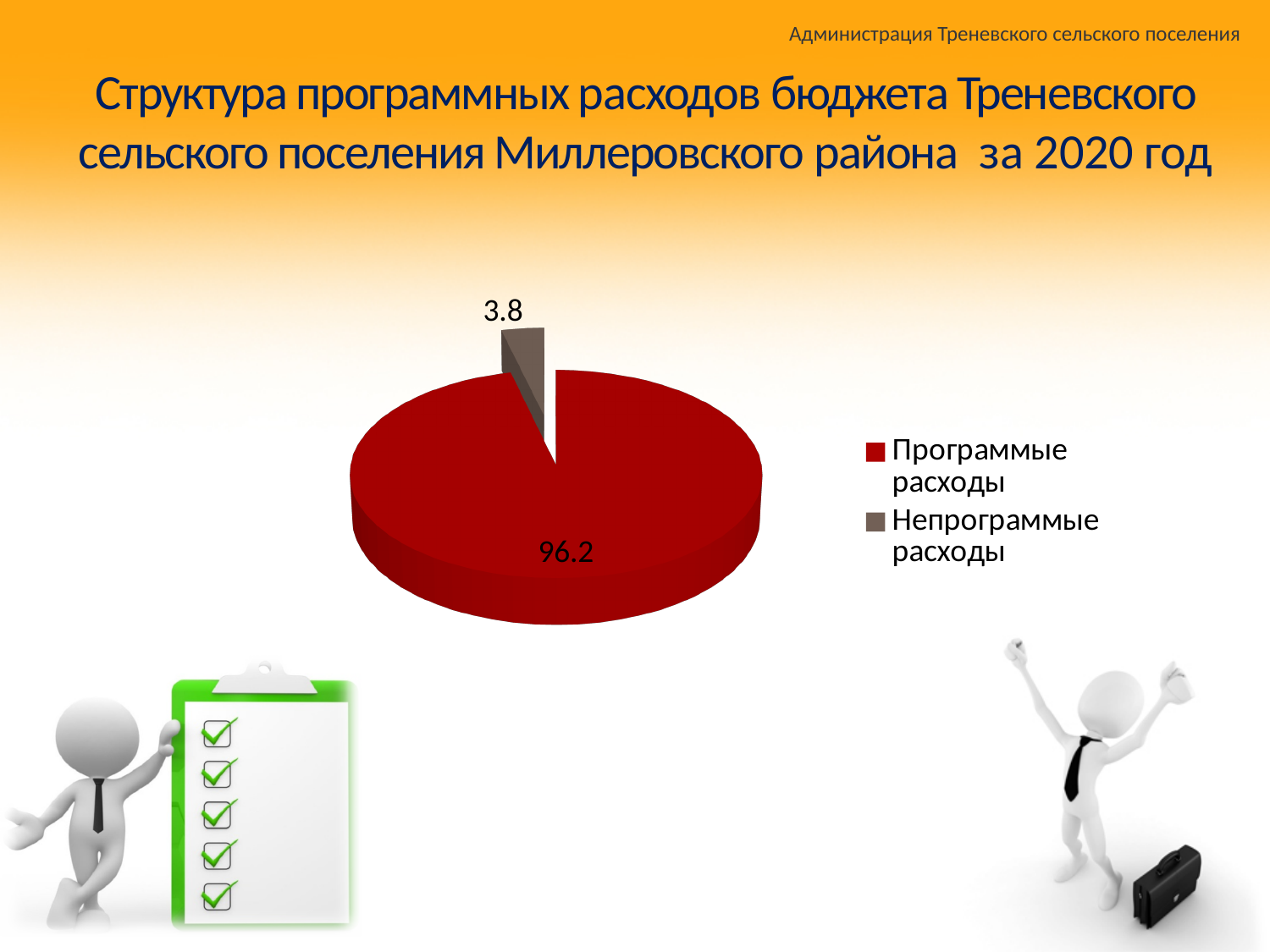
Which category has the largest slice? Программые расходы What colour is the slice for Программые расходы? red What is the value for Программые расходы? 96.2 How many entries does the legend list? 2 Which is larger, Программые расходы or Непрограммые расходы? Программые расходы What is the difference between the values for Программые расходы and Непрограммые расходы? 92.4 What kind of chart is shown on the slide? pie chart What is the value for Непрограммые расходы? 3.8 What colour is the slice for Непрограммые расходы? grey-brown How many slices does the pie chart have? 2 Which category has the smallest slice? Непрограммые расходы